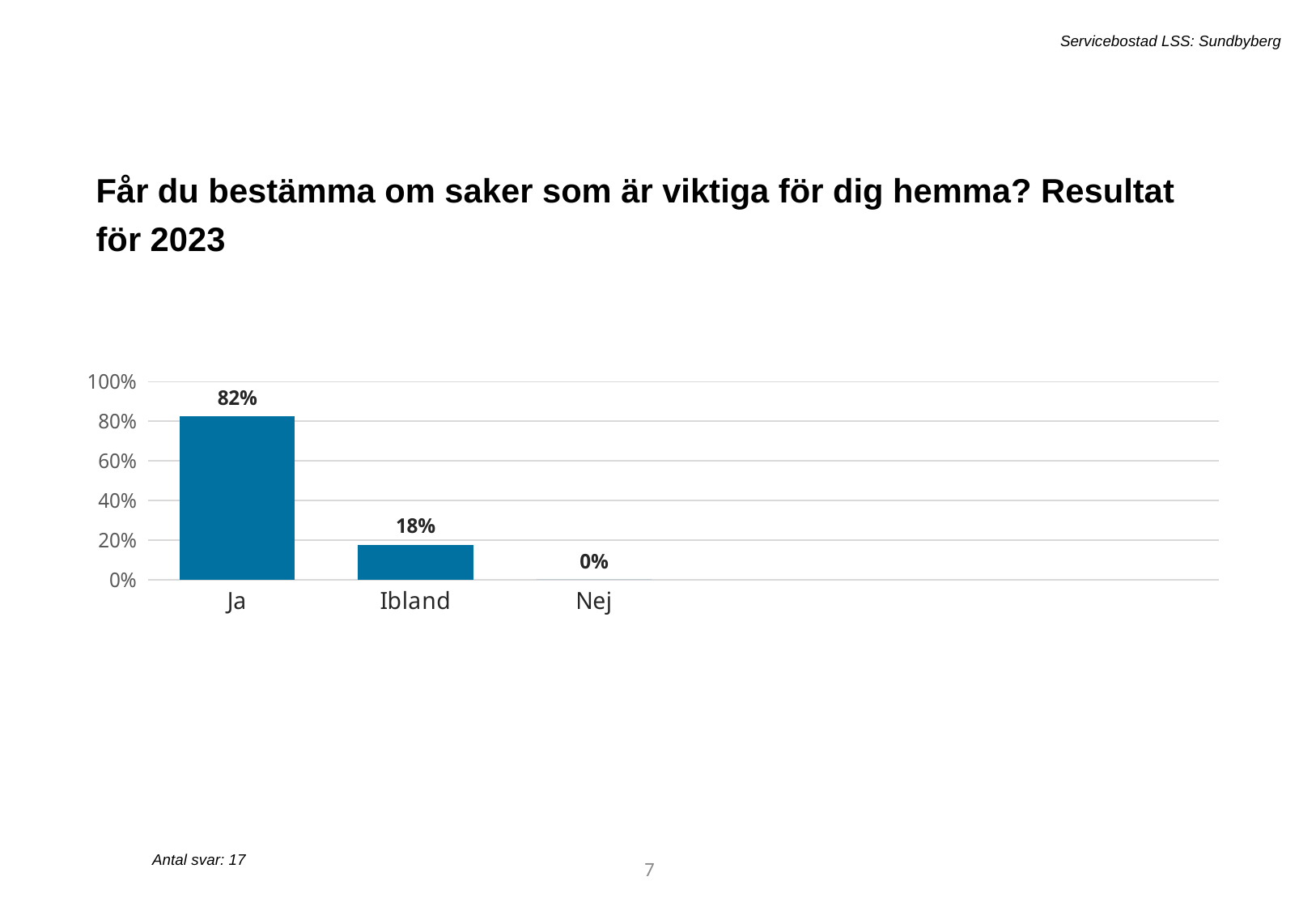
How many categories are shown on the x axis? 3 What is the value for Nej? 0% Is the value for Ja greater or less than 60%? greater Which category has the highest value? Ja Is the value for Ibland greater or less than 40%? less What kind of chart is shown on the slide? bar chart What is the value for Ibland? 18% What is the difference between the values for Ja and Ibland? 64% How many responses (Antal svar) does the slide report? 17 Which is larger, the value for Ibland or the value for Nej? Ibland What is the value for Ja? 82% Which category has the lowest value? Nej